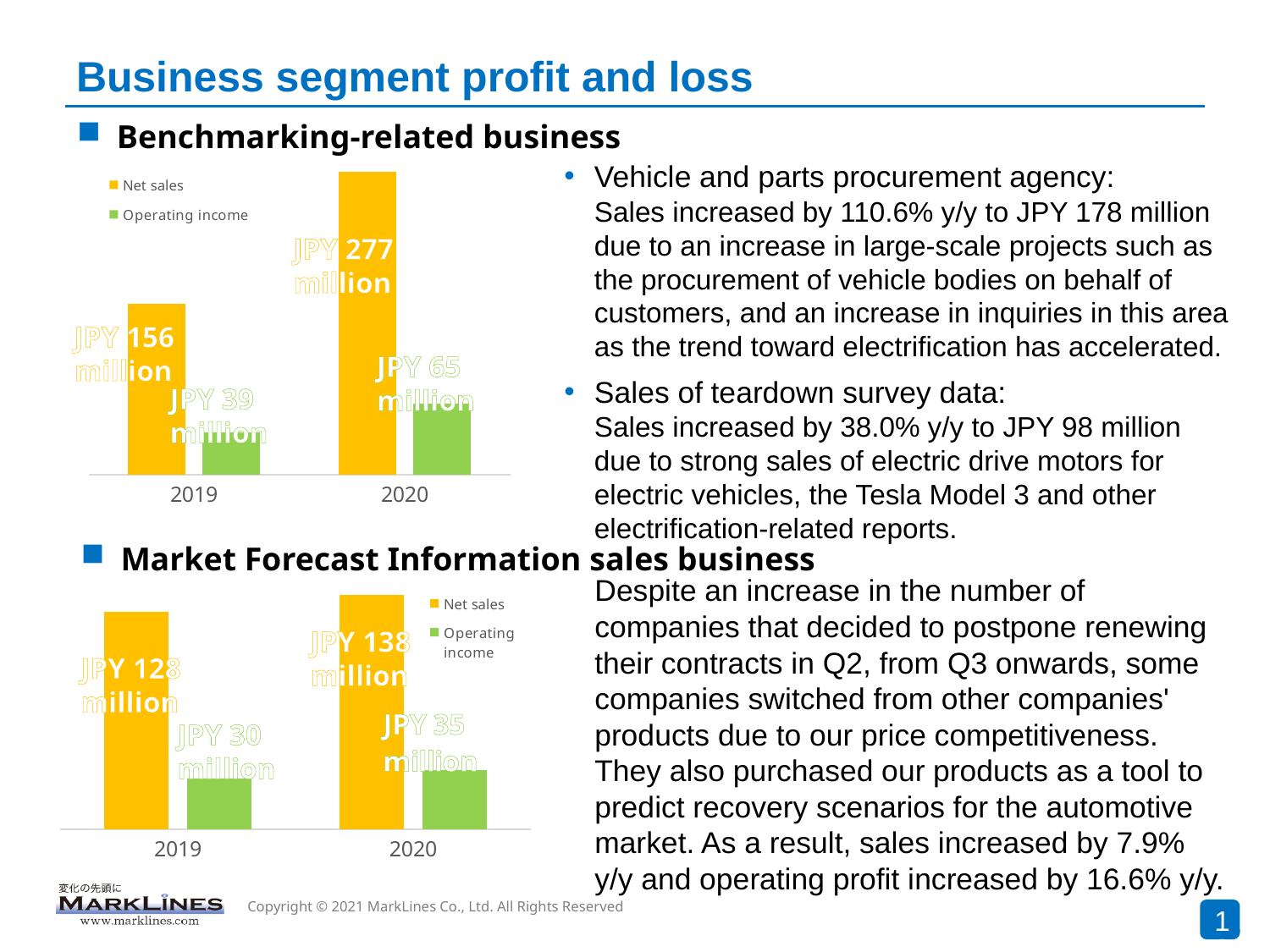
In the Market Forecast Information sales business chart, which colour represents Operating income? green What type of chart is used for the Benchmarking-related business? bar chart In the Market Forecast Information sales business chart, do Net sales rise or fall from 2019 to 2020? rise In the Benchmarking-related business chart, what is the Operating income value for 2019? JPY 39 million In the Market Forecast Information sales business chart, what is the Net sales value for 2019? JPY 128 million In the Benchmarking-related business chart, how many series does the legend list? 2 In the Market Forecast Information sales business chart, what is the difference between Operating income in 2020 and 2019? JPY 5 million In the Benchmarking-related business chart, what is the Net sales value for 2020? JPY 277 million In the Benchmarking-related business chart, which year has the higher Operating income? 2020 In the Benchmarking-related business chart, by how much did Net sales increase from 2019 to 2020? JPY 121 million In the Market Forecast Information sales business chart, what is the Operating income value for 2020? JPY 35 million In the Market Forecast Information sales business chart, how many years are shown on the x axis? 2